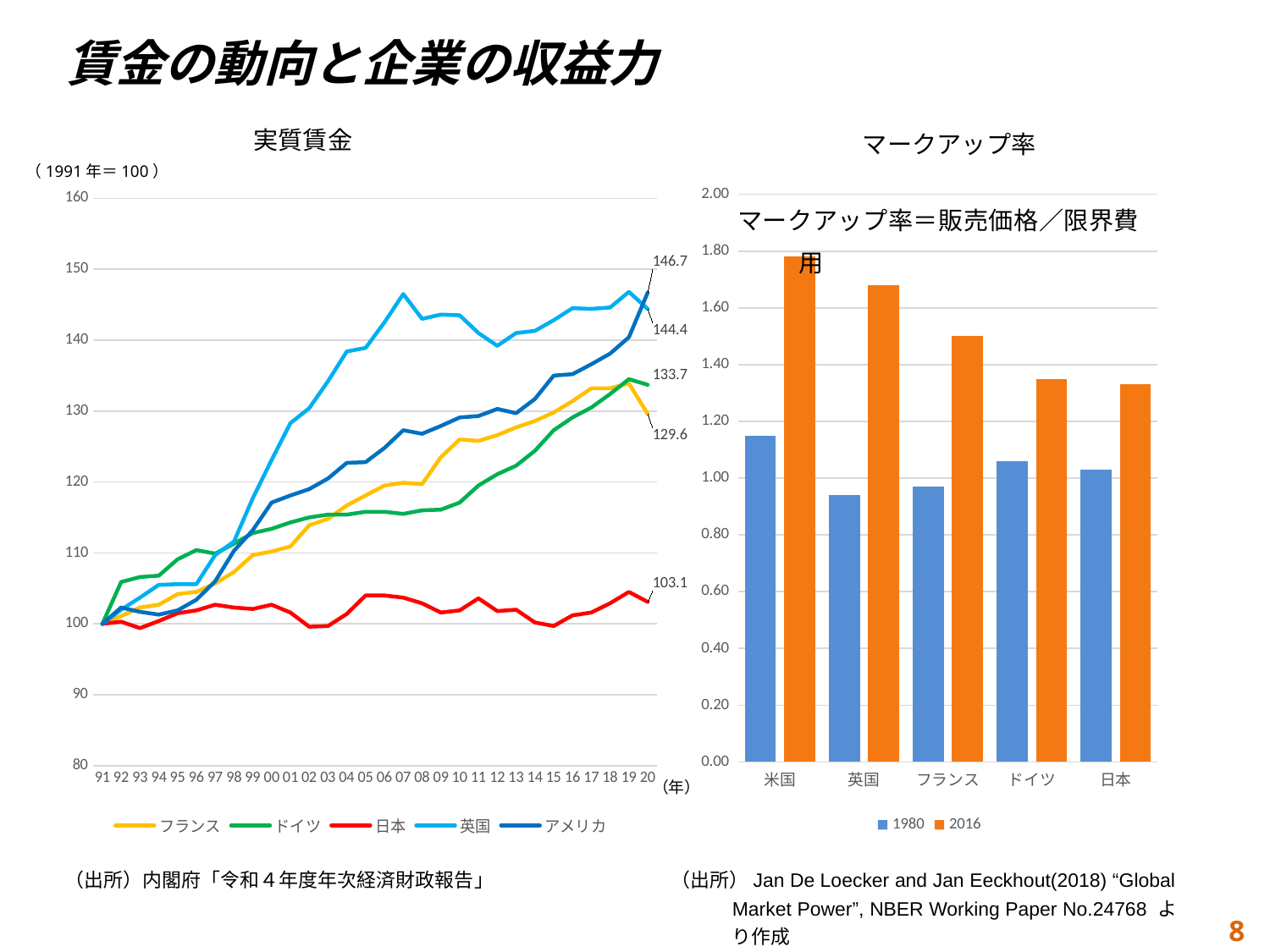
What kind of chart is the 実質賃金 chart on the left? line chart In the マークアップ率 chart, which country has the highest 2016 value? 米国 In the 実質賃金 chart, what is the value for 日本 in 2020? 103.1 In the 実質賃金 chart, what is the value for アメリカ in 2020? 146.7 How many series does the legend of the マークアップ率 chart list? 2 In the マークアップ率 chart, is the 1980 value for 英国 greater or less than 1.00? less In the マークアップ率 chart, is the 2016 value for 米国 greater or less than 1.60? greater In the 実質賃金 chart, what is the difference between the 2020 values for アメリカ and 日本? 43.6 What kind of chart is the マークアップ率 chart on the right? bar chart In the 実質賃金 chart, which country has the lowest value in 2020? 日本 How many countries are shown on the x axis of the マークアップ率 chart? 5 How many series does the legend of the 実質賃金 chart list? 5